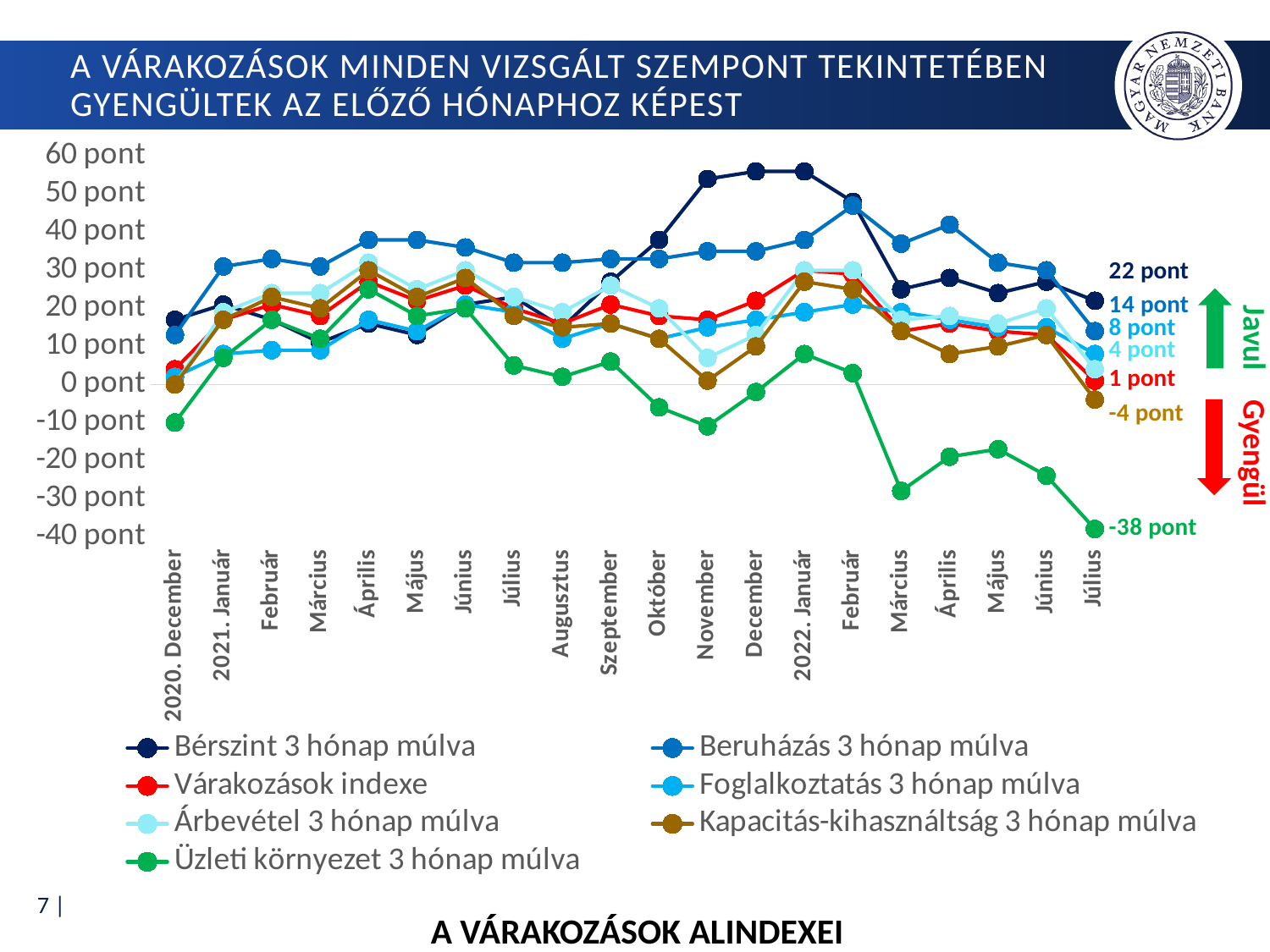
How many series does the legend list? 7 What is the title printed below the chart? A VÁRAKOZÁSOK ALINDEXEI What kind of chart is shown on the slide? line chart Which series has the highest value in 2022 Július? Bérszint 3 hónap múlva What is the difference between Bérszint 3 hónap múlva and Üzleti környezet 3 hónap múlva in 2022 Július? 60 pont How many months are shown along the x axis? 20 Which series has the lowest value in 2022 Július? Üzleti környezet 3 hónap múlva What is the value of Üzleti környezet 3 hónap múlva in 2022 Július? -38 pont What is the value of Kapacitás-kihasználtság 3 hónap múlva in 2022 Július? -4 pont What is the value of Bérszint 3 hónap múlva in 2022 Július? 22 pont Is the value for Bérszint 3 hónap múlva in 2021 December greater or less than 50 pont? greater What is the value of Várakozások indexe in 2022 Július? 1 pont